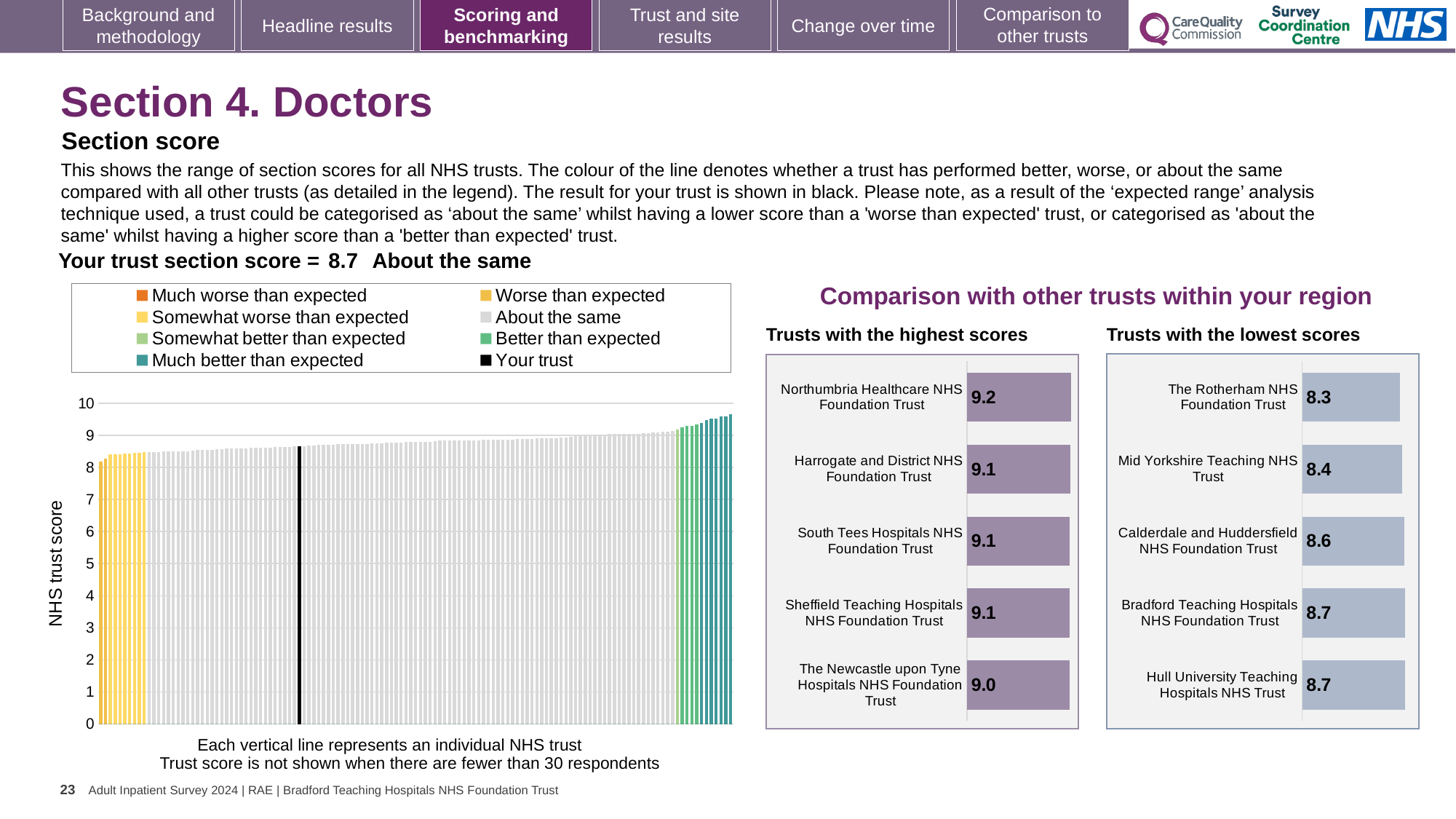
In the 'Trusts with the lowest scores' chart, what is the difference between the scores of Calderdale and Huddersfield NHS Foundation Trust and The Rotherham NHS Foundation Trust? 0.3 In the 'Trusts with the highest scores' chart, how many trusts are shown? 5 What kind of chart is the large chart on the left showing the range of section scores for all NHS trusts? Bar chart In the 'Trusts with the lowest scores' chart, which has the larger score: Mid Yorkshire Teaching NHS Trust or Calderdale and Huddersfield NHS Foundation Trust? Calderdale and Huddersfield NHS Foundation Trust In the 'Trusts with the highest scores' chart, what is the score for The Newcastle upon Tyne Hospitals NHS Foundation Trust? 9.0 In the 'Trusts with the lowest scores' chart, what is the score for The Rotherham NHS Foundation Trust? 8.3 In the 'Trusts with the lowest scores' chart, what is the score for Calderdale and Huddersfield NHS Foundation Trust? 8.6 In the 'Trusts with the highest scores' chart, which trust has the highest score? Northumbria Healthcare NHS Foundation Trust In the large chart on the left showing the range of section scores, is the value for the black 'Your trust' bar greater or less than 9? less In the 'Trusts with the highest scores' chart, what is the difference between the scores of Northumbria Healthcare NHS Foundation Trust and The Newcastle upon Tyne Hospitals NHS Foundation Trust? 0.2 In the 'Trusts with the lowest scores' chart, which trust has the lowest score? The Rotherham NHS Foundation Trust In the 'Trusts with the highest scores' chart, what is the score for Northumbria Healthcare NHS Foundation Trust? 9.2